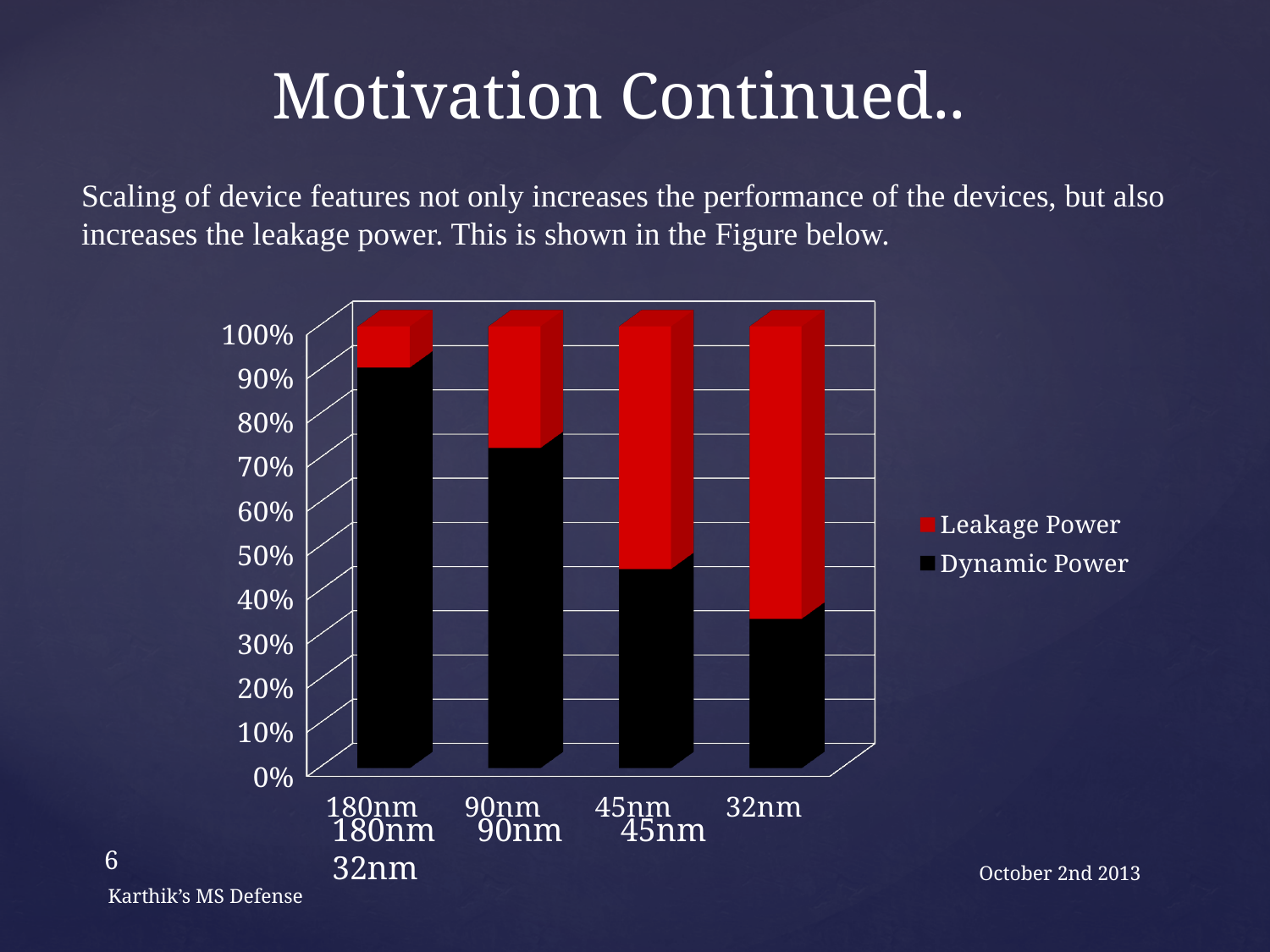
How many categories are shown on the x axis of the chart? 4 What kind of chart is shown on the slide? stacked bar chart Which has a larger Dynamic Power share, 90nm or 45nm? 90nm Is the Dynamic Power share for 180nm greater or less than 80%? greater Which series is shown in red in the chart? Leakage Power Which category has the lowest Dynamic Power share? 32nm Does the Dynamic Power share rise or fall moving from 180nm to 32nm along the x axis? fall Which series is shown in black in the chart? Dynamic Power How many series does the chart's legend list? 2 Which category has the highest Dynamic Power share? 180nm Which category has the largest Leakage Power share? 32nm Is the Dynamic Power share for 32nm greater or less than 50%? less